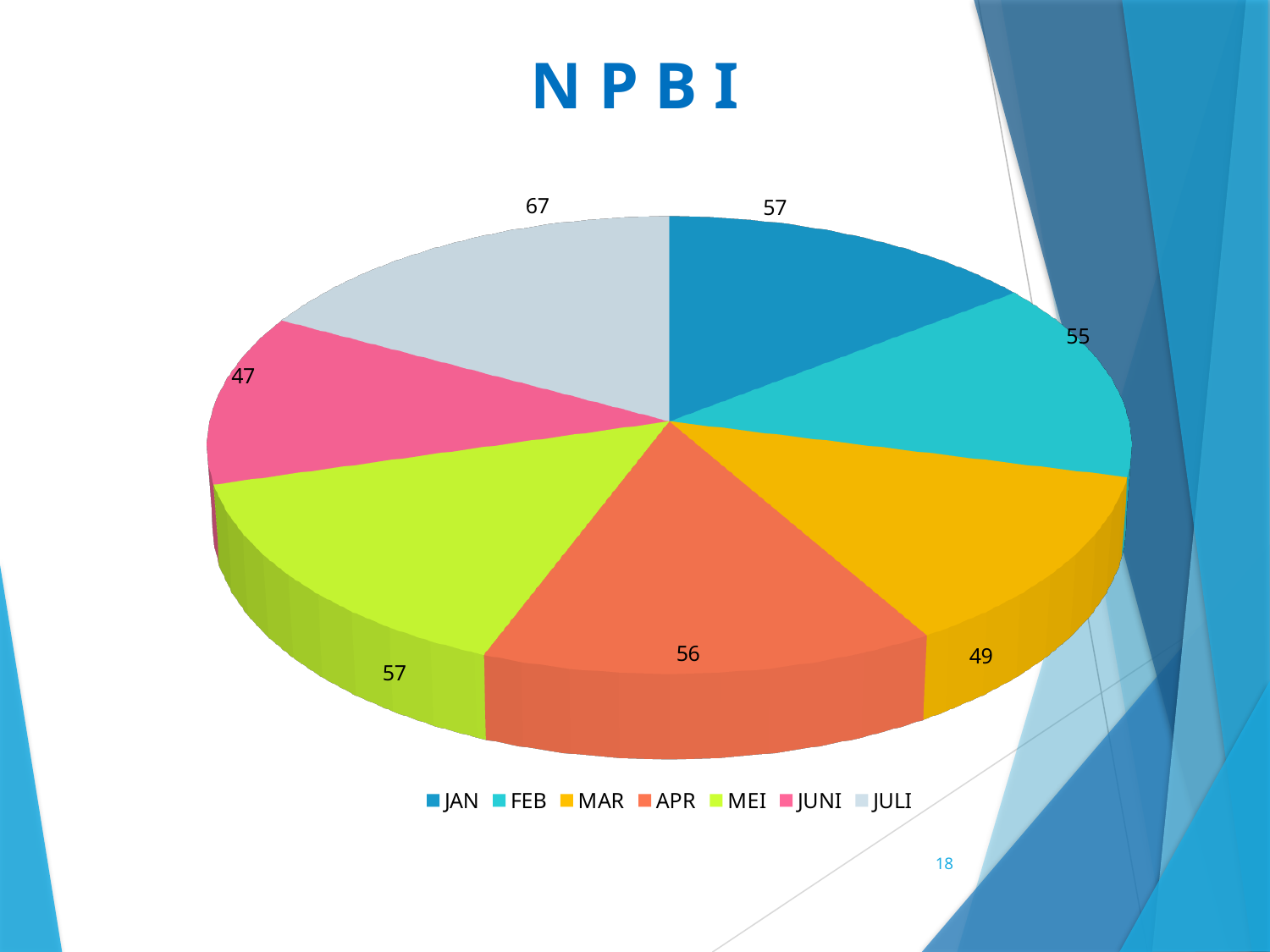
What is the value for MAR? 49 What is the value for APR? 56 How many slices does the pie chart have? 7 What is the title of the chart? N P B I What is the difference between the values for JULI and JUNI? 20 Which month has the largest slice? JULI How many entries does the legend list? 7 Which is larger, the value for FEB or the value for MAR? FEB Which month has the smallest slice? JUNI What is the value for JAN? 57 What is the value for JULI? 67 What kind of chart is shown on the slide? pie chart